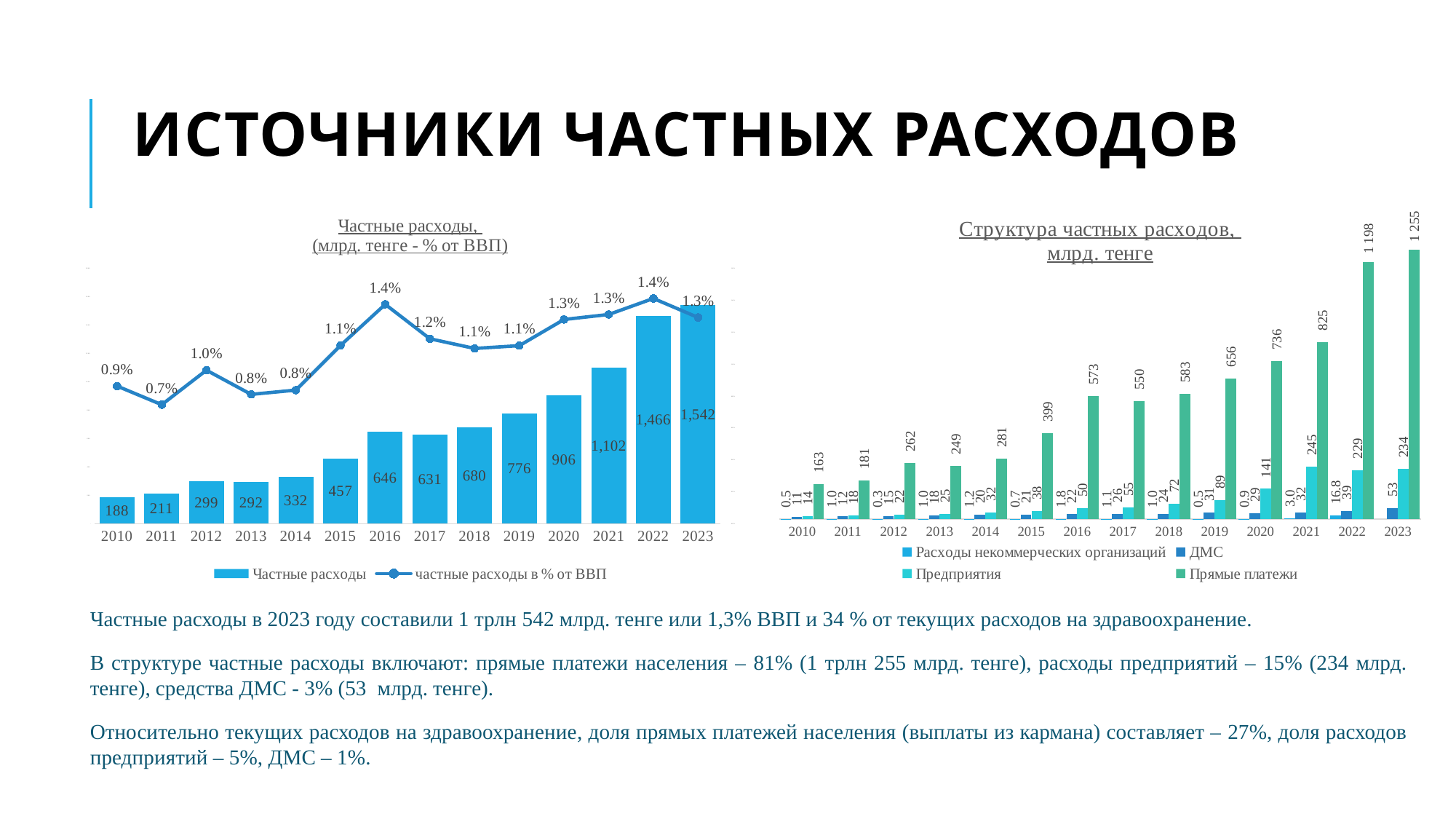
In the chart 'Частные расходы, (млрд. тенге - % от ВВП)', what is the value of the bar for 2023? 1,542 In the chart 'Структура частных расходов, млрд. тенге', what is the value of 'ДМС' for 2023? 53 How many series does the legend of the chart 'Структура частных расходов, млрд. тенге' list? 4 In the chart 'Структура частных расходов, млрд. тенге', what is the value of 'Прямые платежи' for 2023? 1 255 In the chart 'Частные расходы, (млрд. тенге - % от ВВП)', what is the value of the bar for 2015? 457 In the chart 'Частные расходы, (млрд. тенге - % от ВВП)', what is the value of the line 'частные расходы в % от ВВП' for 2016? 1.4% In the chart 'Частные расходы, (млрд. тенге - % от ВВП)', which year has the lowest bar value? 2010 In the chart 'Структура частных расходов, млрд. тенге', what is the value of 'Предприятия' for 2021? 245 What kind of chart is 'Структура частных расходов, млрд. тенге'? Bar chart In the chart 'Частные расходы, (млрд. тенге - % от ВВП)', which is larger, the bar for 2016 or the bar for 2017? 2016 In the chart 'Частные расходы, (млрд. тенге - % от ВВП)', what is the difference between the bar values for 2022 and 2021? 364 How many years are shown on the x axis of the chart 'Частные расходы, (млрд. тенге - % от ВВП)'? 14